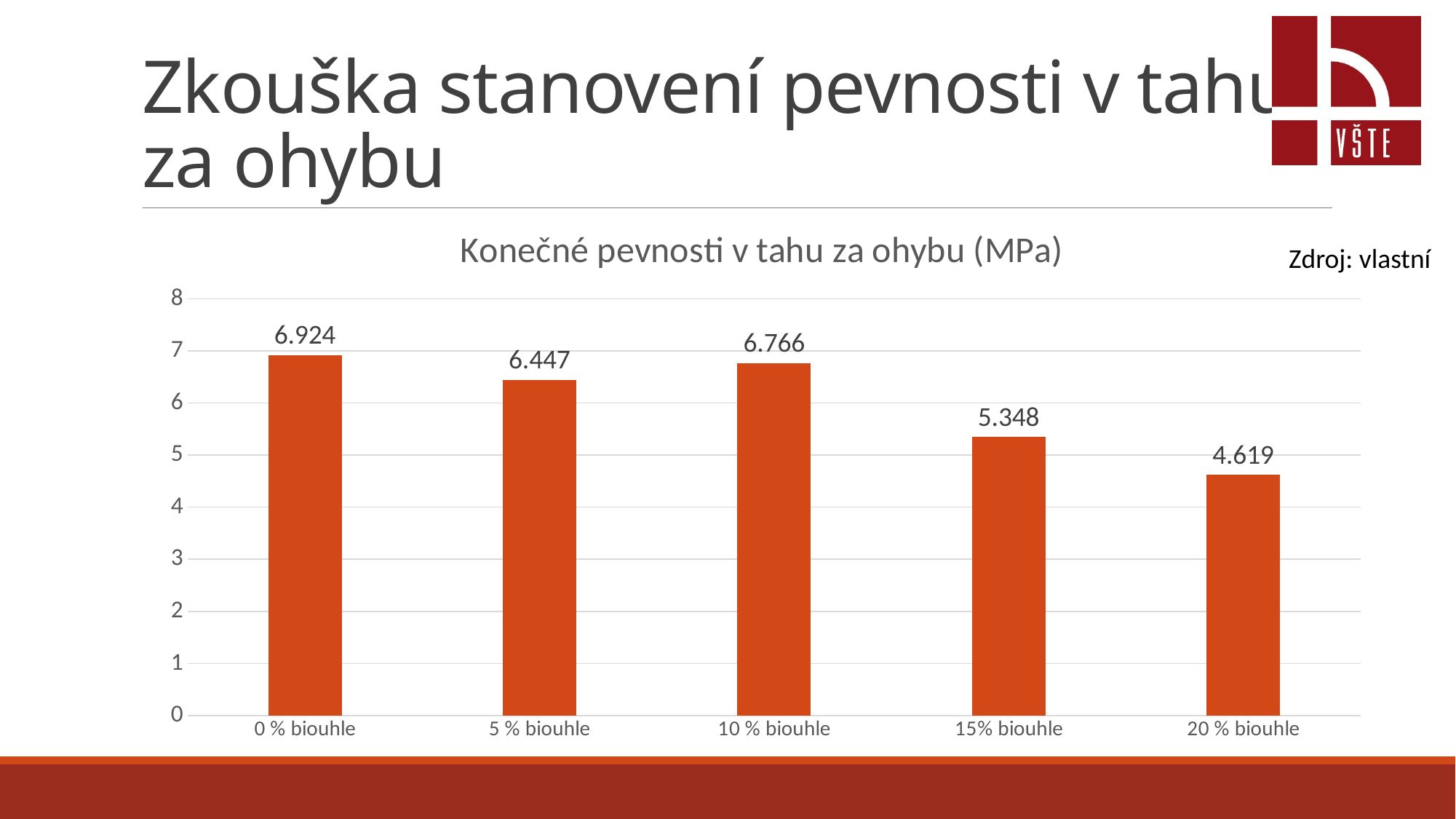
What is the value for 20 % biouhle? 4.619 What is the value for 15% biouhle? 5.348 Which category has the highest value? 0 % biouhle Which category has the lowest value? 20 % biouhle Is the value for 15% biouhle greater or less than 6? less Which is larger, the value for 5 % biouhle or the value for 10 % biouhle? 10 % biouhle What kind of chart is shown on the slide? bar chart How many categories are shown on the x axis? 5 What is the title of the chart? Konečné pevnosti v tahu za ohybu (MPa) What is the value for 0 % biouhle? 6.924 What is the difference between the values for 0 % biouhle and 20 % biouhle? 2.305 What is the difference between the values for 10 % biouhle and 5 % biouhle? 0.319